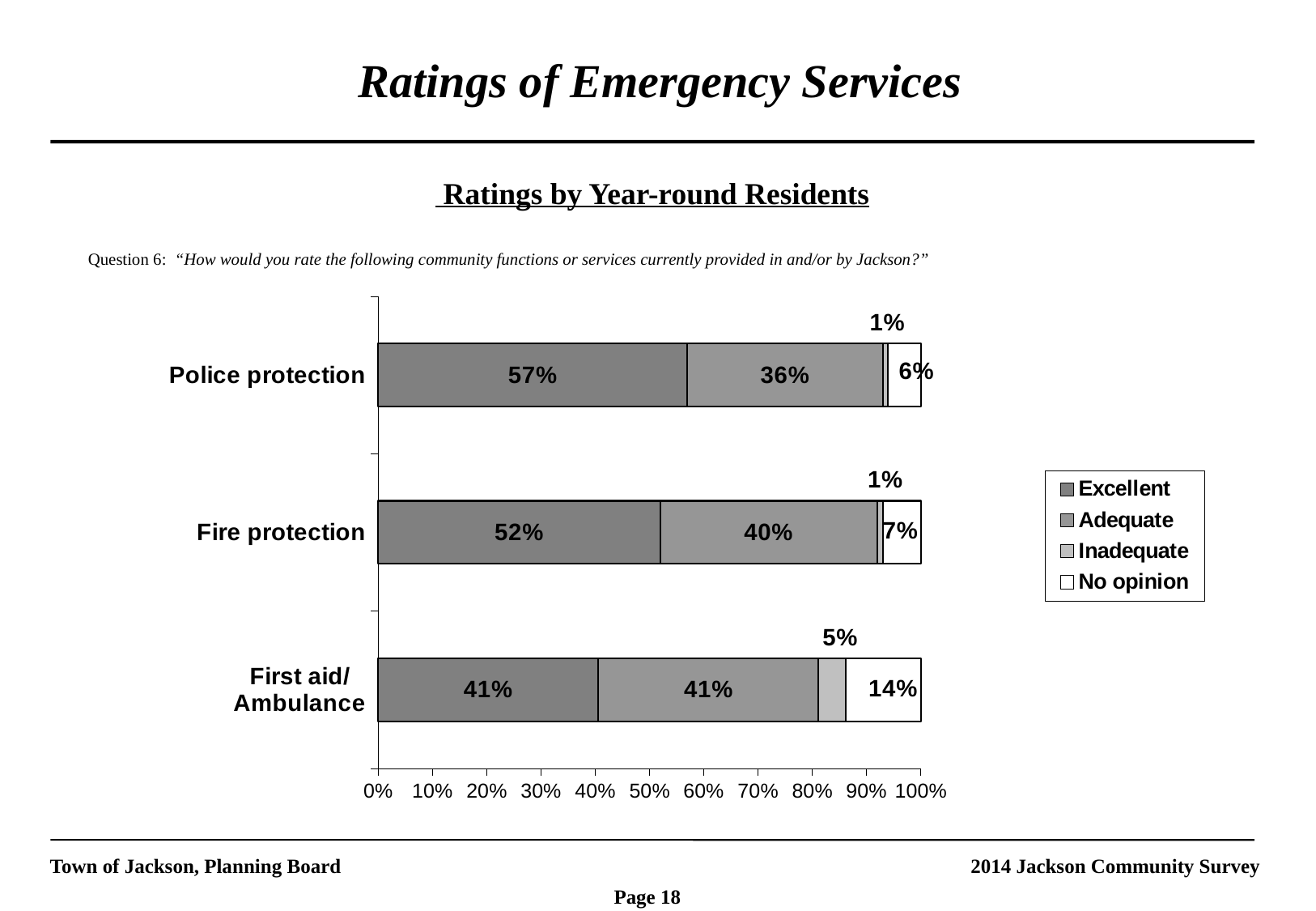
What is the Inadequate value for First aid/Ambulance? 5% What percentage of year-round residents rated Fire protection as Adequate? 40% Which is larger: the Adequate rating for Police protection or the Adequate rating for Fire protection? Fire protection How many series does the legend list? 4 What percentage of year-round residents rated Police protection as Excellent? 57% What is the combined Excellent and Adequate rating for Fire protection? 92% What is the No opinion value for First aid/Ambulance? 14% How many services are shown on the chart? 3 Which service has the highest Excellent rating? Police protection Which service has the lowest Excellent rating? First aid/Ambulance What kind of chart is shown on the slide? Stacked bar chart What is the difference between the Excellent ratings for Police protection and Fire protection? 5%